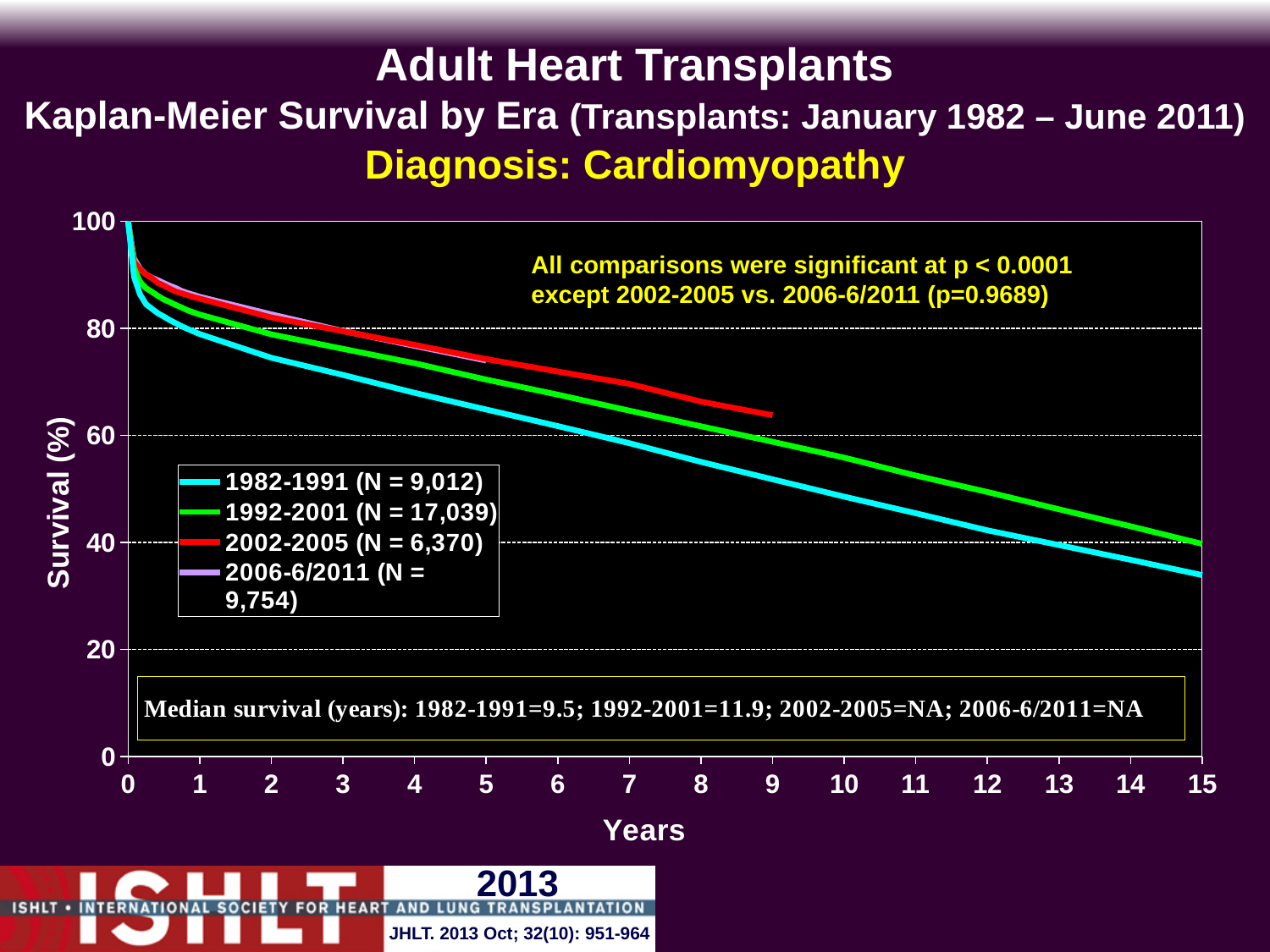
Which era has the smallest N in the legend? 2002-2005 What kind of chart is shown on the slide? line chart What is the median survival in years for the 1992-2001 era? 11.9 What is the median survival in years for the 2002-2005 era? NA Do the survival curves rise or fall as years increase? fall At 5 years, which era has higher survival: 1982-1991 or 1992-2001? 1992-2001 What is the N for the 1982-1991 era shown in the legend? 9,012 How many series (eras) does the legend list? 4 Which era has the largest N in the legend? 1992-2001 What is the difference in median survival (years) between the 1992-2001 and 1982-1991 eras? 2.4 Is the survival value for the 1982-1991 era at 10 years greater or less than 60? less Is the survival value for the 1982-1991 era at 15 years greater or less than 40? less